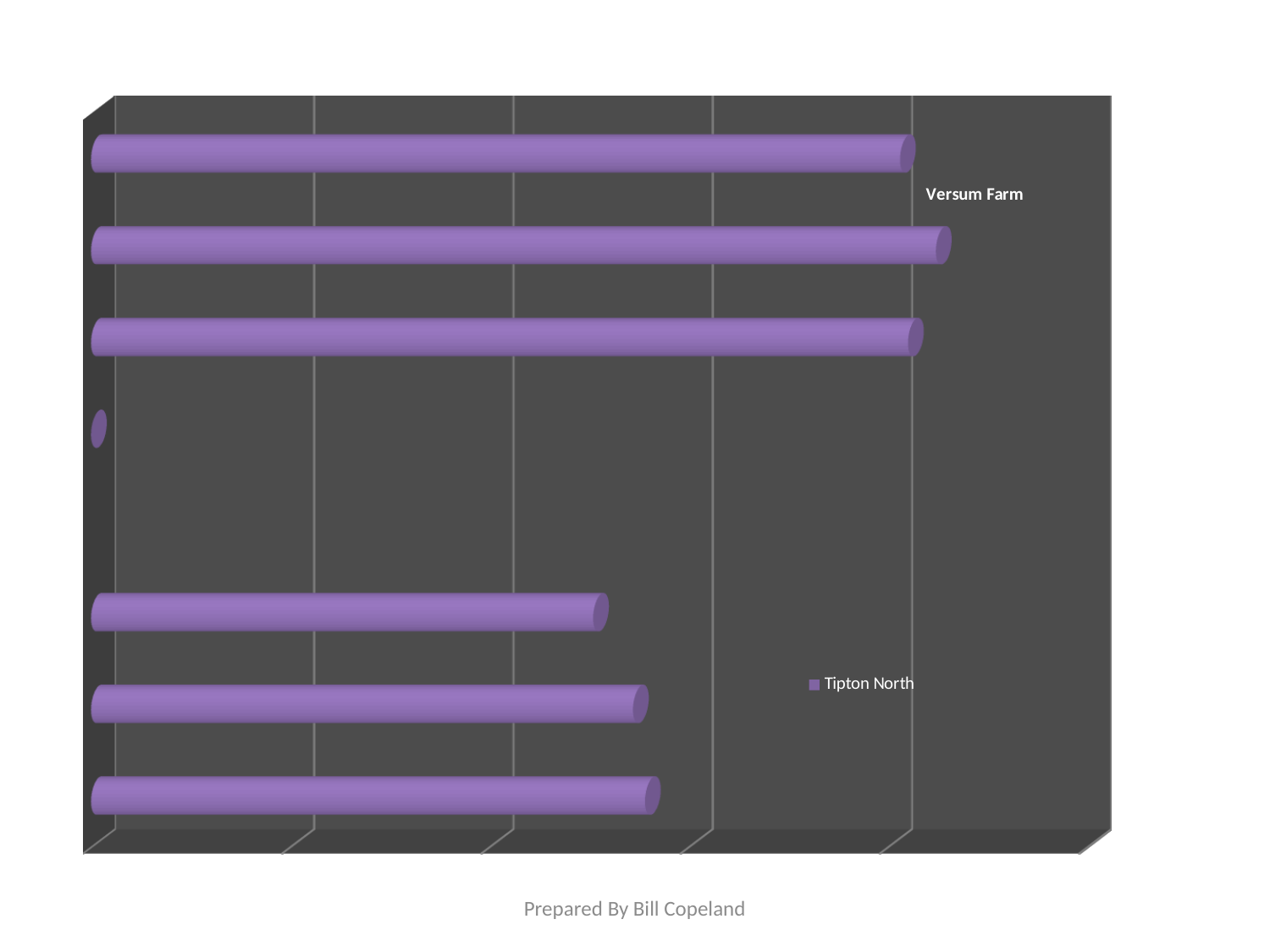
Counting from the top, which bar in the chart is the shortest? the fourth bar Which is longer in the chart: the top bar or the bottom bar? the top bar What series name appears in the chart's legend? Tipton North How many series does the chart's legend list? 1 What kind of chart is shown on the slide? bar chart How many bars are plotted in the chart? 7 What colour are the bars in the chart? purple Counting from the top, which bar in the chart is the longest? the second bar